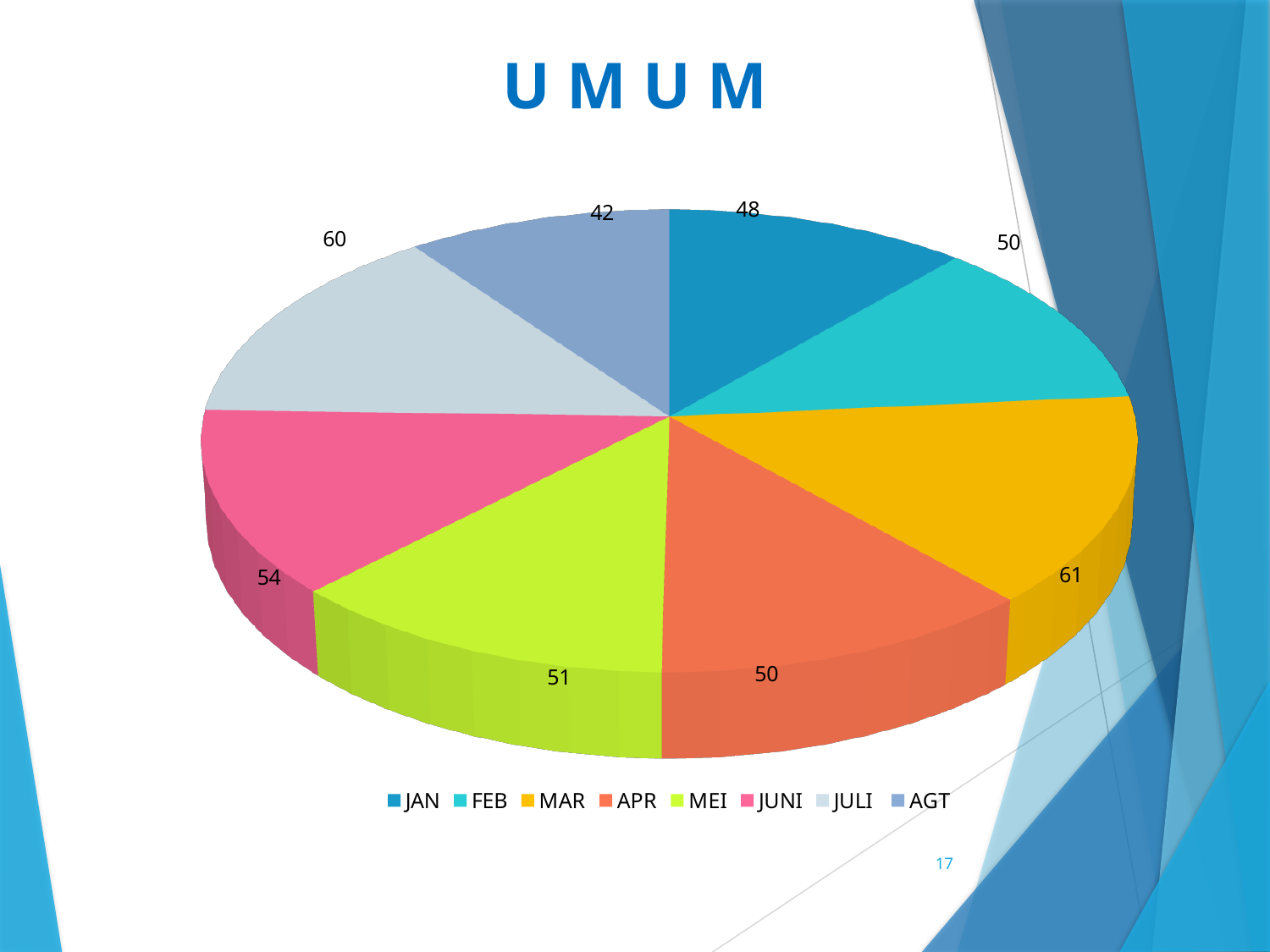
What is the value for JULI? 60 Which month has the largest slice? MAR What type of chart is shown on the slide? Pie chart What is the title of the chart? UMUM What is the value for MAR? 61 What is the difference between the values for MAR and AGT? 19 What is the value for JAN? 48 What is the value for AGT? 42 Which is larger, the value for JUNI or the value for MEI? JUNI How many slices does the pie chart have? 8 Which legend entry is shown in pink? JUNI Which month has the smallest slice? AGT